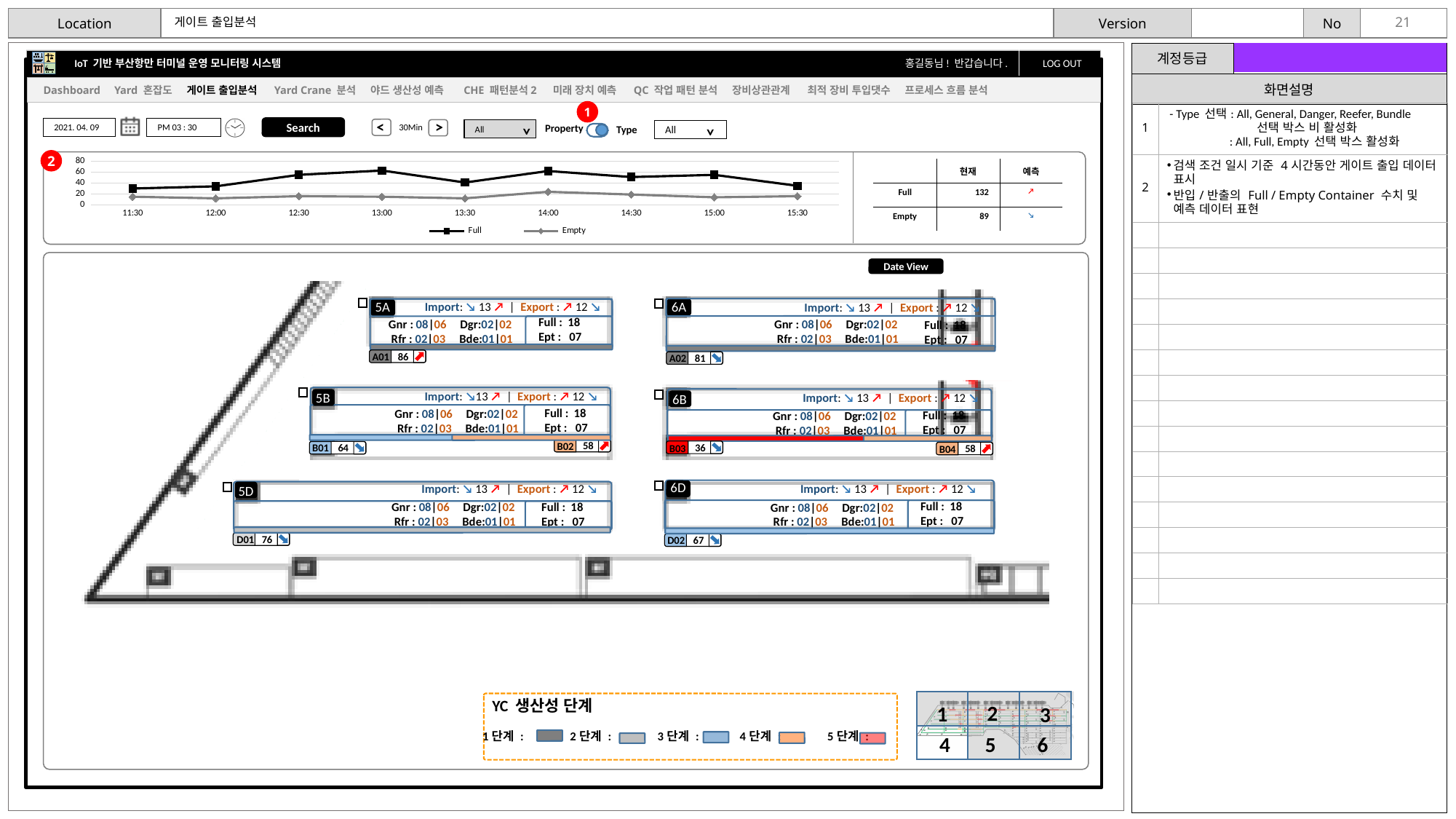
How many series does the legend of the line chart list? 2 In the line chart, is the Full value at 11:30 greater or less than 40? less What are the two series named in the line chart's legend? Full and Empty In the line chart, is the Full value at 13:00 greater or less than 40? greater What kind of chart is shown at the top of the dashboard? line chart How many time points are labelled on the x axis of the line chart? 9 In the line chart, which series stays higher across all time points, Full or Empty? Full In the line chart, is the Empty value at 12:00 greater or less than 20? less In the line chart, does the Full series rise or fall from 12:00 to 13:00? rise In the line chart, which series has the larger value at 13:00, Full or Empty? Full What is the highest tick value shown on the y axis of the line chart? 80